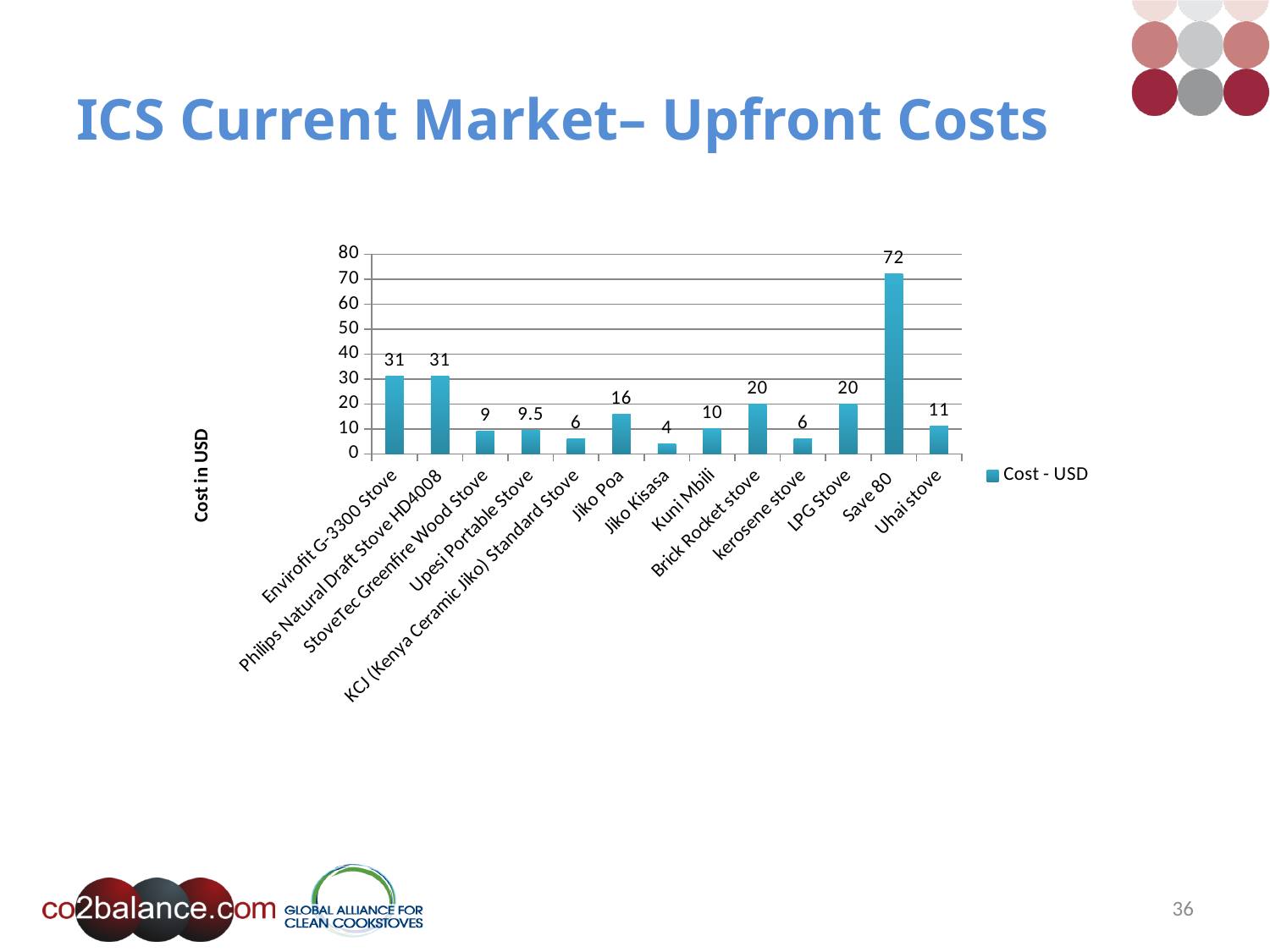
What is the difference in cost between the Save 80 and the Envirofit G-3300 Stove? 41 How many stoves are shown on the x axis of the chart? 13 What is the cost in USD for the Upesi Portable Stove? 9.5 What kind of chart is shown on the slide? Bar chart What is the cost in USD for the Jiko Poa? 16 What is the label of the series in the legend? Cost - USD Which stove has the highest upfront cost? Save 80 What is the cost in USD for the Save 80 stove? 72 How many series does the legend list? 1 What is the y-axis label of the chart? Cost in USD Which stove has the lowest upfront cost? Jiko Kisasa Which costs more, the Brick Rocket stove or the Kuni Mbili? Brick Rocket stove